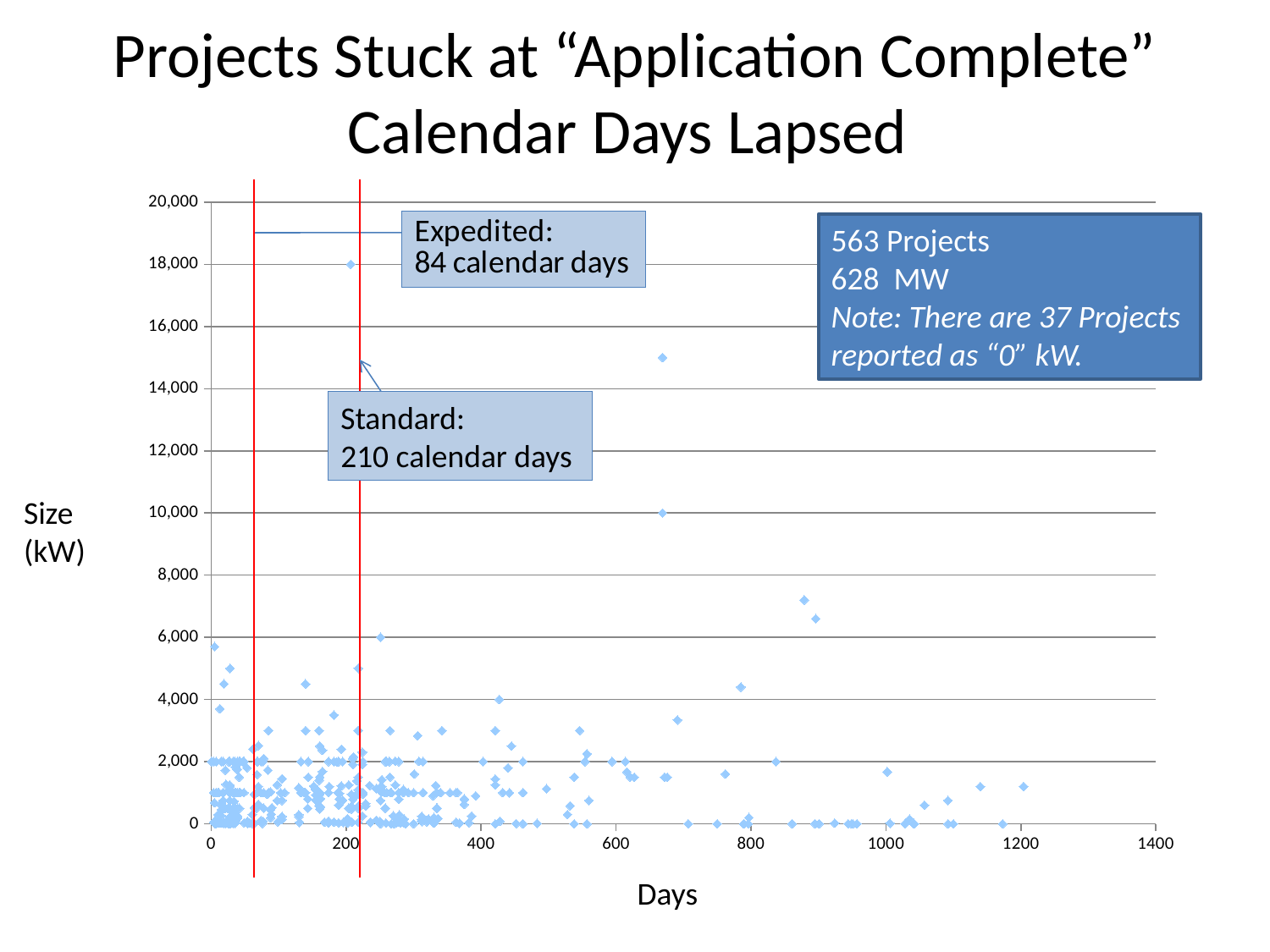
Is the size of the highest plotted point greater or less than 16,000 kW? greater Is the size of the point plotted near 670 days at the upper part of the chart greater or less than 14,000 kW? greater What is the title of the chart? Projects Stuck at "Application Complete" Calendar Days Lapsed What is the maximum value shown on the y axis? 20,000 What is the label of the x axis? Days How many projects are reported as "0" kW according to the note? 37 What total capacity in MW does the text box report? 628 MW How many calendar days does the Expedited annotation give? 84 calendar days What is the maximum value shown on the x axis? 1400 How many calendar days does the Standard annotation give? 210 calendar days How many projects does the text box say are included? 563 Projects What kind of chart is shown on the slide? Scatter plot